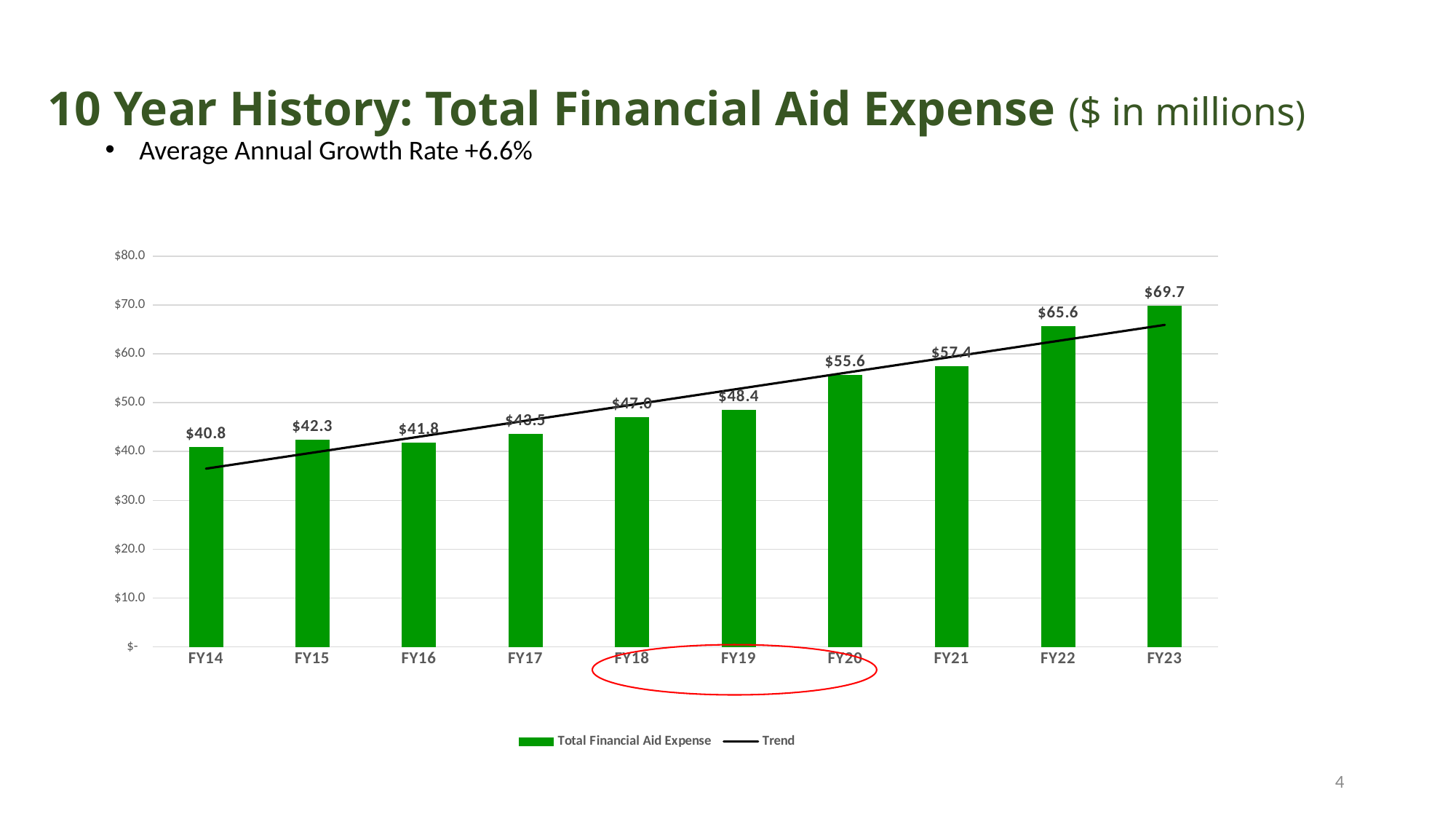
What is the Total Financial Aid Expense for FY23? $69.7 Does the Total Financial Aid Expense generally rise or fall from FY14 to FY23? Rise What is the Total Financial Aid Expense for FY20? $55.6 Which fiscal year has the lowest Total Financial Aid Expense? FY14 Is the Total Financial Aid Expense for FY21 greater or less than $50.0? greater What is the difference between the Total Financial Aid Expense in FY23 and FY22? $4.1 How many series does the legend list? 2 Which fiscal year has the highest Total Financial Aid Expense? FY23 How many fiscal years are shown on the x axis? 10 Which is larger, the Total Financial Aid Expense in FY15 or FY16? FY15 What kind of chart is used to show the Total Financial Aid Expense? Bar chart What is the Total Financial Aid Expense for FY14? $40.8